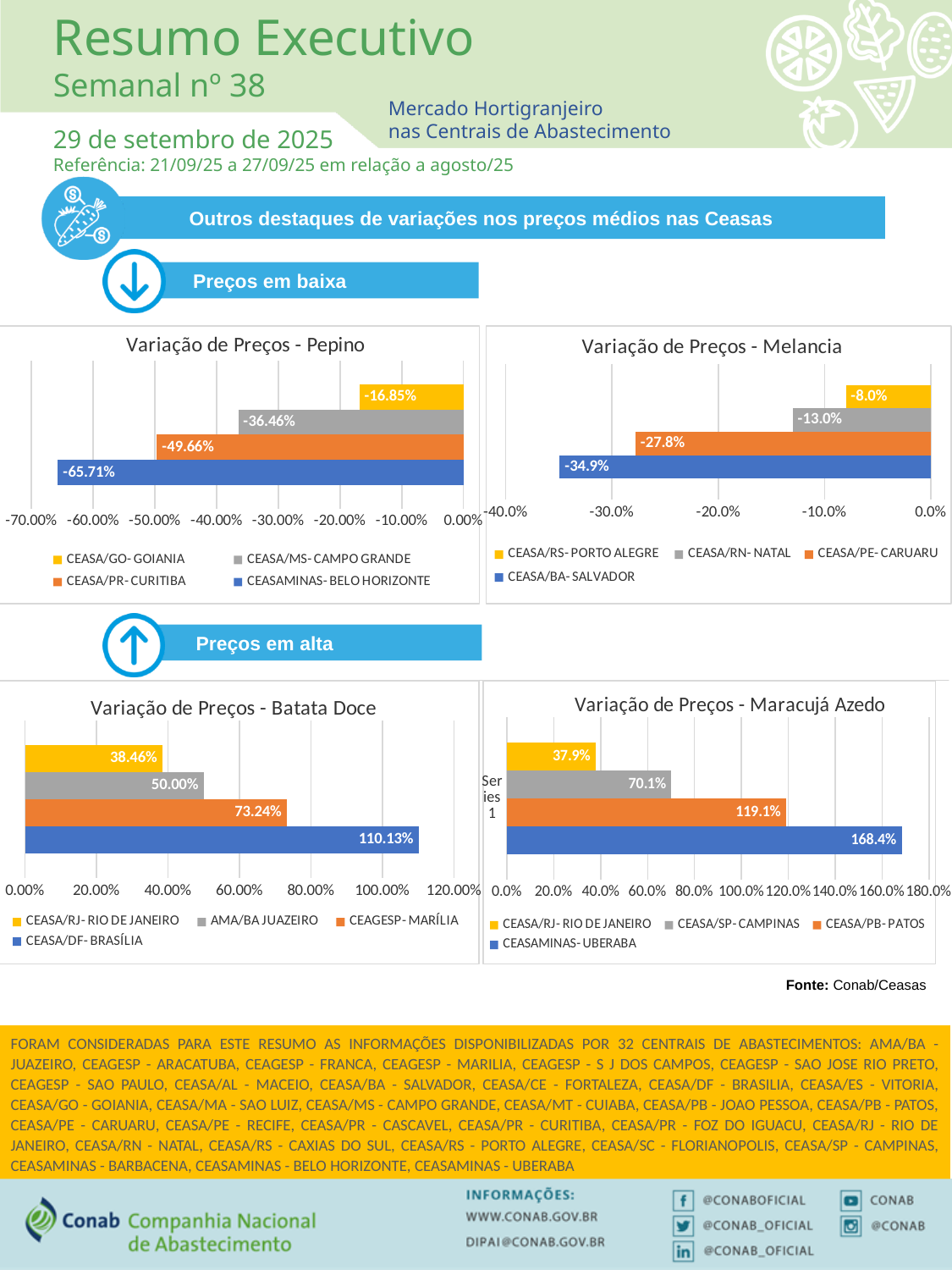
In the 'Variação de Preços - Batata Doce' chart, what is the difference between the values for CEASA/DF- BRASÍLIA and AMA/BA JUAZEIRO? 60.13% In the 'Variação de Preços - Batata Doce' chart, what is the value for CEAGESP- MARÍLIA? 73.24% In the 'Variação de Preços - Melancia' chart, what is the value for CEASA/PE- CARUARU? -27.8% In the 'Variação de Preços - Batata Doce' chart, which category has the highest value? CEASA/DF- BRASÍLIA In the 'Variação de Preços - Pepino' chart, which category has the smallest decline (value closest to zero)? CEASA/GO- GOIANIA In the 'Variação de Preços - Melancia' chart, what is the difference between the values for CEASA/RS- PORTO ALEGRE and CEASA/RN- NATAL? 5.0% In the 'Variação de Preços - Maracujá Azedo' chart, which is larger: the value for CEASA/PB- PATOS or CEASAMINAS- UBERABA? CEASAMINAS- UBERABA In the 'Variação de Preços - Melancia' chart, which category has the lowest value? CEASA/BA- SALVADOR In the 'Variação de Preços - Pepino' chart, what is the value for CEASAMINAS- BELO HORIZONTE? -65.71% In the 'Variação de Preços - Maracujá Azedo' chart, what is the value for CEASA/SP- CAMPINAS? 70.1% What type of chart is 'Variação de Preços - Pepino'? Bar chart How many categories does the legend of the 'Variação de Preços - Maracujá Azedo' chart list? 4